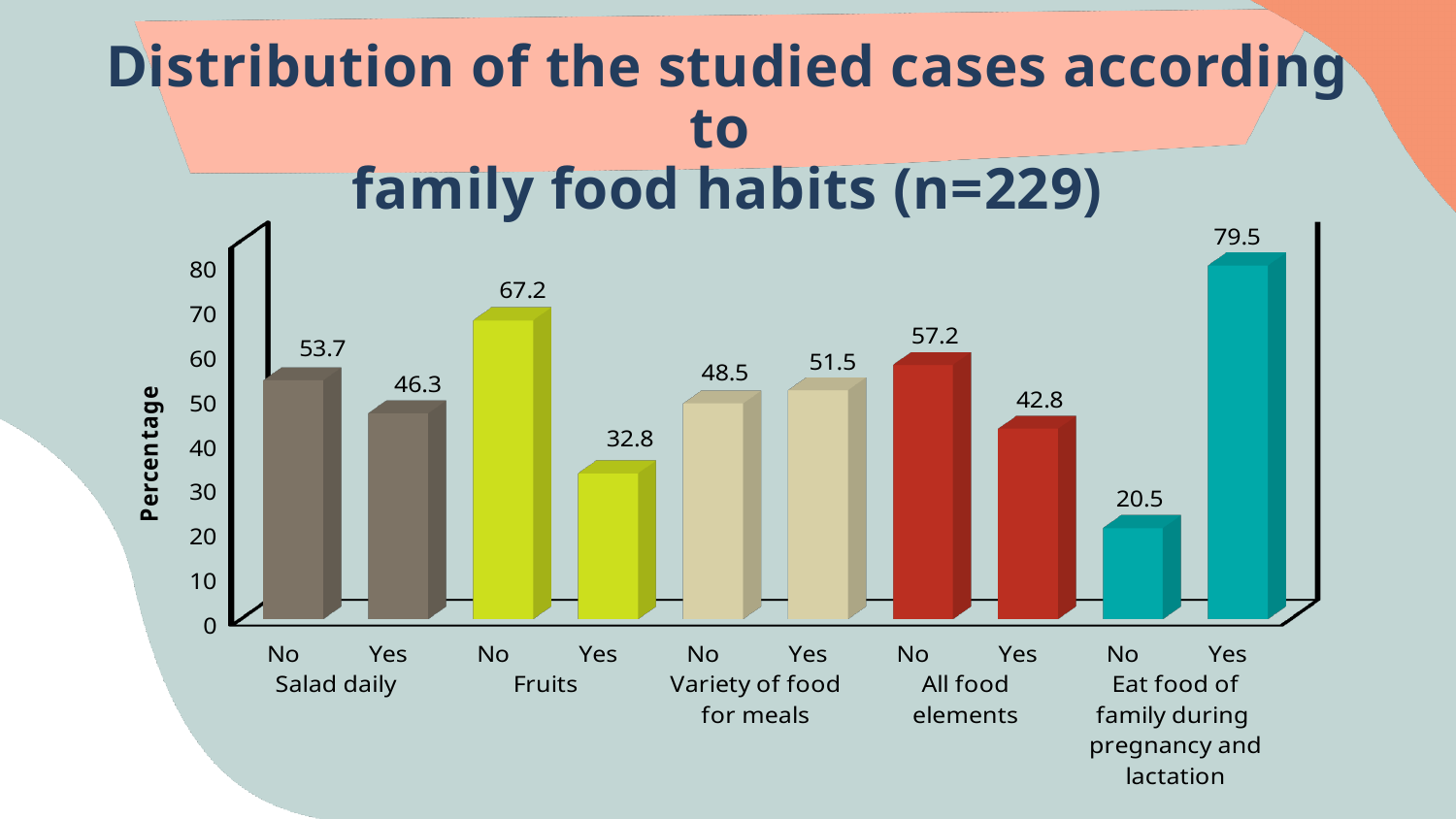
Is the value for 'No' under Fruits greater or less than 60? greater What is the difference between the 'No' and 'Yes' values for Fruits? 34.4 What percentage of cases answered 'Yes' for Fruits? 32.8 Which is larger: the 'No' value for Variety of food for meals or the 'Yes' value for Variety of food for meals? Yes (51.5) How many bars are plotted on the chart? 10 Which bar has the highest value on the chart? Yes, Eat food of family during pregnancy and lactation (79.5) Which bar has the lowest value on the chart? No, Eat food of family during pregnancy and lactation (20.5) What type of chart is shown on the slide? Bar chart What is the value for 'Yes' under Eat food of family during pregnancy and lactation? 79.5 What percentage of cases answered 'No' for Salad daily? 53.7 What is the label of the vertical axis? Percentage What is the difference between the 'No' and 'Yes' values for All food elements? 14.4